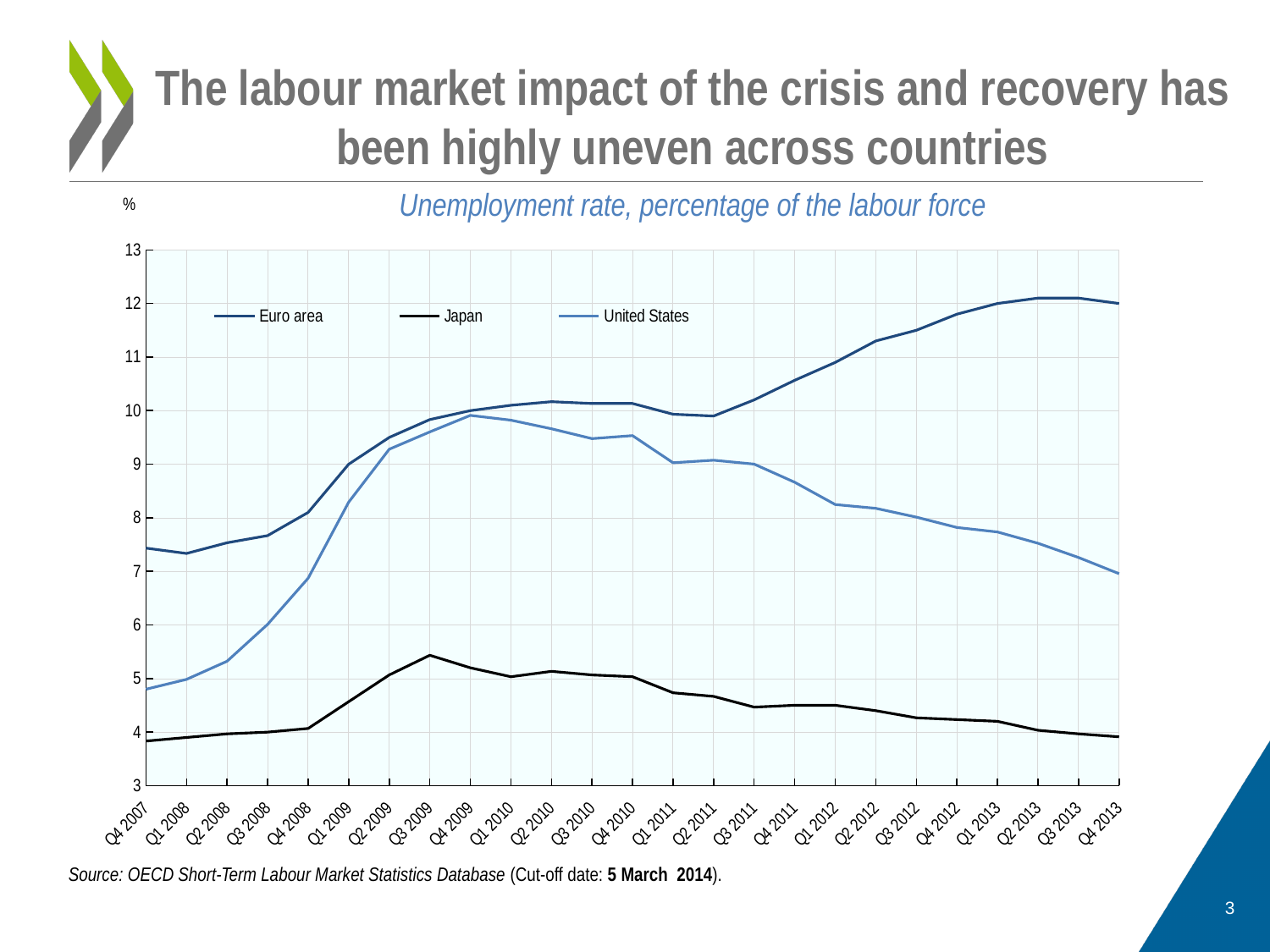
How many series does the legend list? 3 Which series has the highest value at Q4 2013? Euro area What kind of chart is shown on the slide? line chart Which series has the lowest value at Q4 2013? Japan What is the title of the chart? Unemployment rate, percentage of the labour force How many quarters are shown on the x axis? 25 Which series are listed in the legend? Euro area, Japan, United States Is the value for Japan at Q3 2009 greater or less than 5? greater Is the value for the Euro area at Q4 2013 greater or less than 11? greater Is the value for the United States at Q4 2013 greater or less than 8? less Does the United States series rise or fall from Q4 2009 to Q4 2013? fall At Q4 2007, which is higher: the United States or Japan? United States